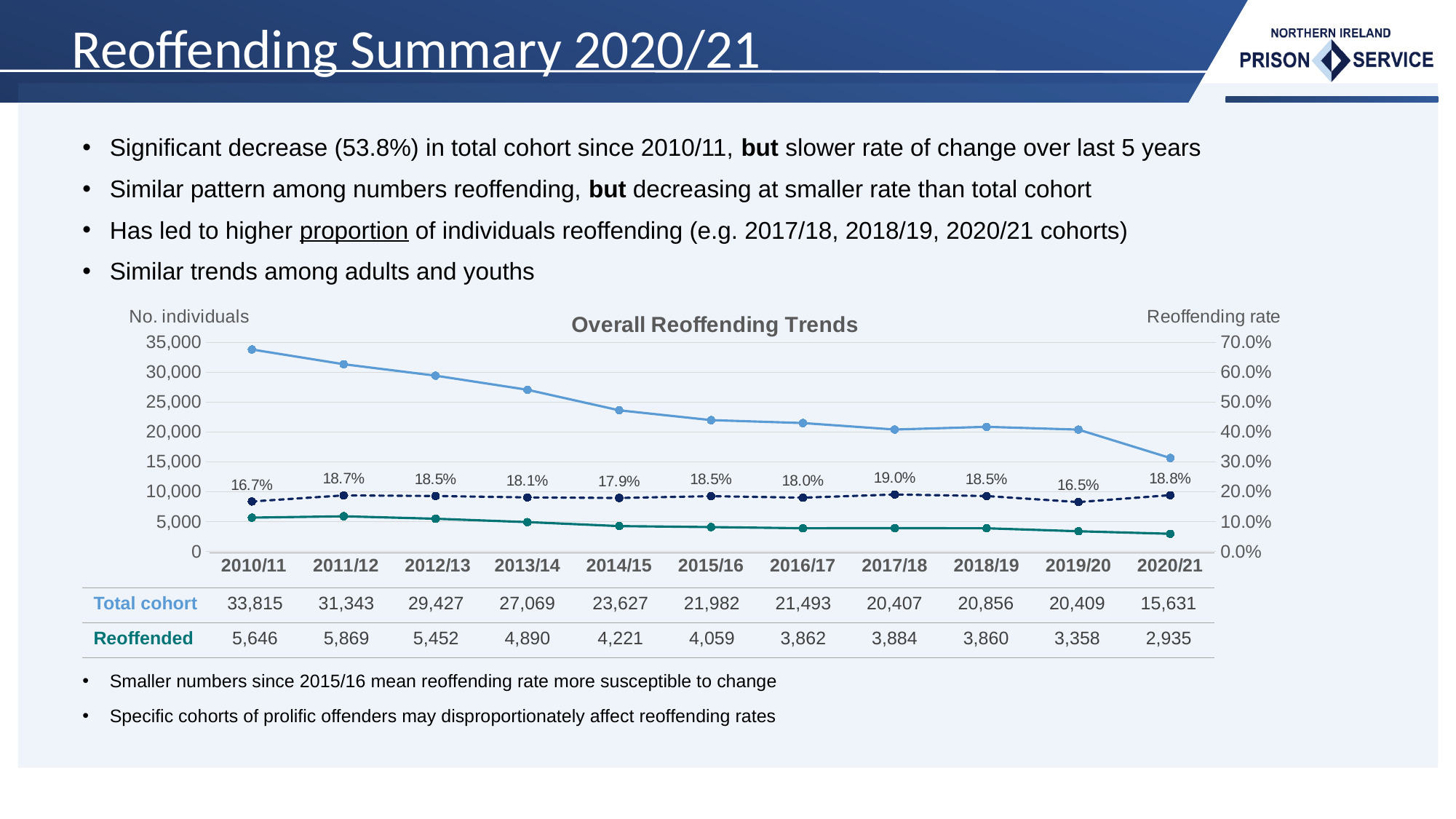
What is the title of the chart? Overall Reoffending Trends Which year had more individuals Reoffended, 2010/11 or 2011/12? 2011/12 How many cohort years are plotted on the chart? 11 By how much did the Total cohort fall between 2010/11 and 2020/21? 18,184 What is the reoffending rate shown for 2017/18? 19.0% How many individuals Reoffended in the 2020/21 cohort? 2,935 Which year has the lowest reoffending rate? 2019/20 What is the Total cohort value for 2010/11? 33,815 What kind of chart is used to show the Overall Reoffending Trends? line chart Does the Total cohort line generally rise or fall from 2010/11 to 2020/21? fall Which year has the highest reoffending rate? 2017/18 Is the Total cohort value for 2014/15 greater or less than 25,000? less